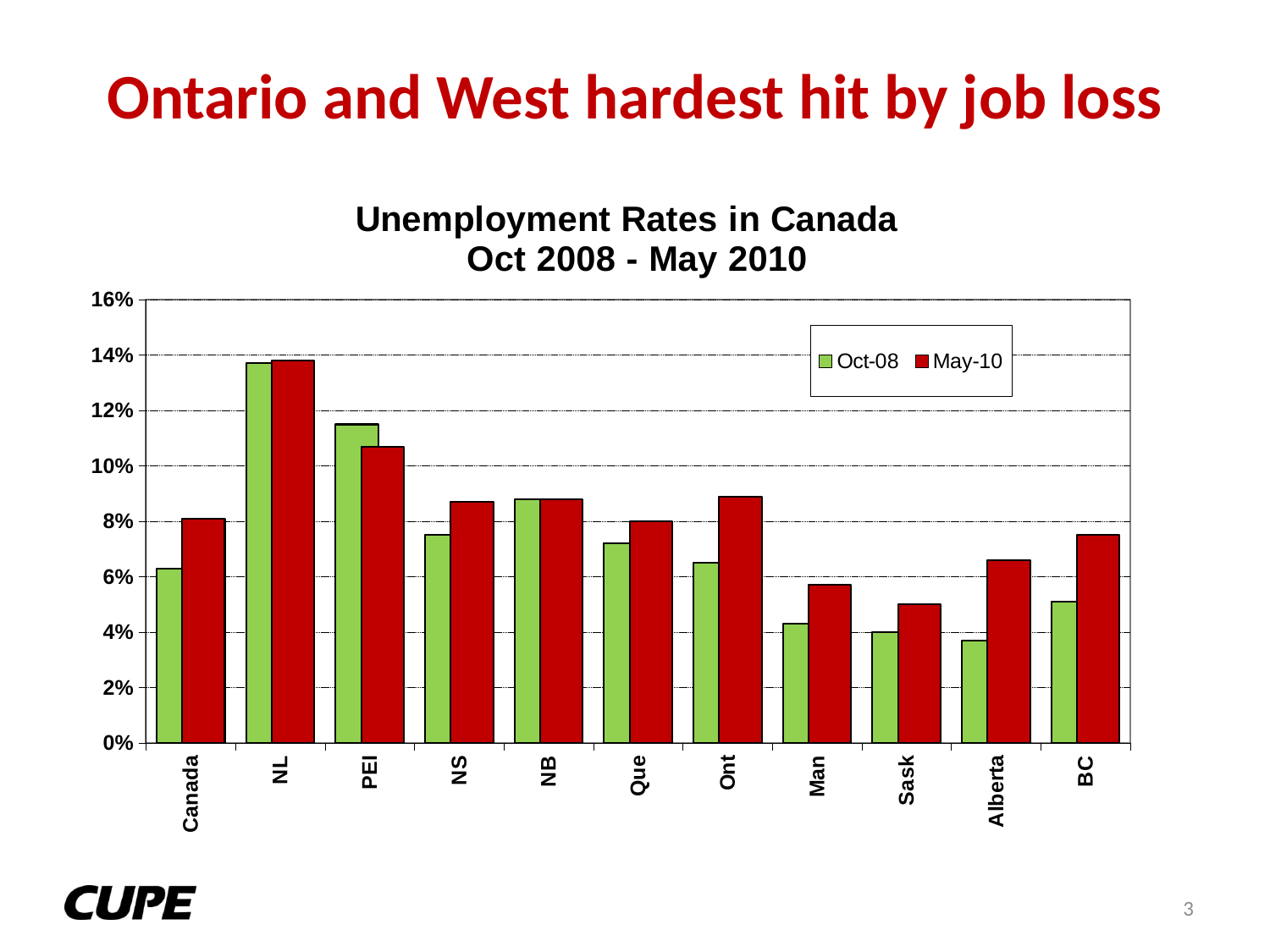
For PEI, which is larger: the Oct-08 value or the May-10 value? Oct-08 How many categories are shown on the x axis? 11 Which category has the highest May-10 unemployment rate? NL Which category has the lowest May-10 unemployment rate? Sask Which category has the lowest Oct-08 unemployment rate? Alberta Is the May-10 value for PEI greater or less than 12%? less What is the title of the chart? Unemployment Rates in Canada Oct 2008 - May 2010 How many series does the legend list? 2 Is the May-10 value for Ont greater or less than 8%? greater What kind of chart is shown on the slide? Bar chart Which is larger: the May-10 value for Ont or the May-10 value for Que? Ont